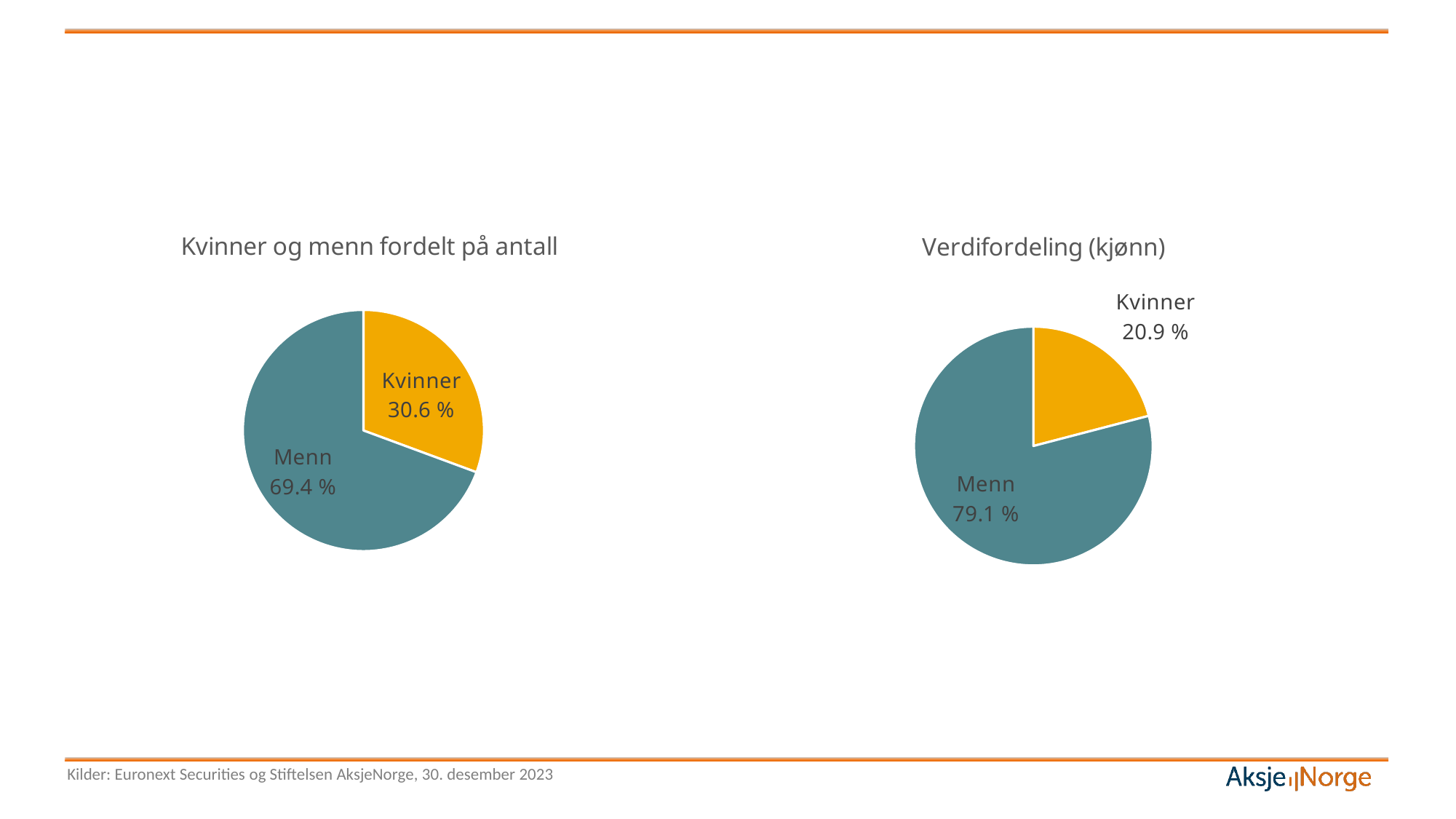
In the chart titled 'Verdifordeling (kjønn)', what colour is the Kvinner slice? Yellow In the chart titled 'Verdifordeling (kjønn)', what share does the Kvinner slice have? 20.9 % What kind of chart is the chart titled 'Verdifordeling (kjønn)'? Pie chart Is the Kvinner share larger in the chart titled 'Kvinner og menn fordelt på antall' or in the chart titled 'Verdifordeling (kjønn)'? Kvinner og menn fordelt på antall How many slices does the chart titled 'Kvinner og menn fordelt på antall' have? 2 In the chart titled 'Verdifordeling (kjønn)', what share does the Menn slice have? 79.1 % In the chart titled 'Kvinner og menn fordelt på antall', what share does the Kvinner slice have? 30.6 % In the chart titled 'Kvinner og menn fordelt på antall', which slice is the largest? Menn In the chart titled 'Verdifordeling (kjønn)', what is the difference between the Menn and Kvinner shares? 58.2 % In the chart titled 'Kvinner og menn fordelt på antall', what is the difference between the Menn and Kvinner shares? 38.8 % In the chart titled 'Verdifordeling (kjønn)', which slice is the smallest? Kvinner